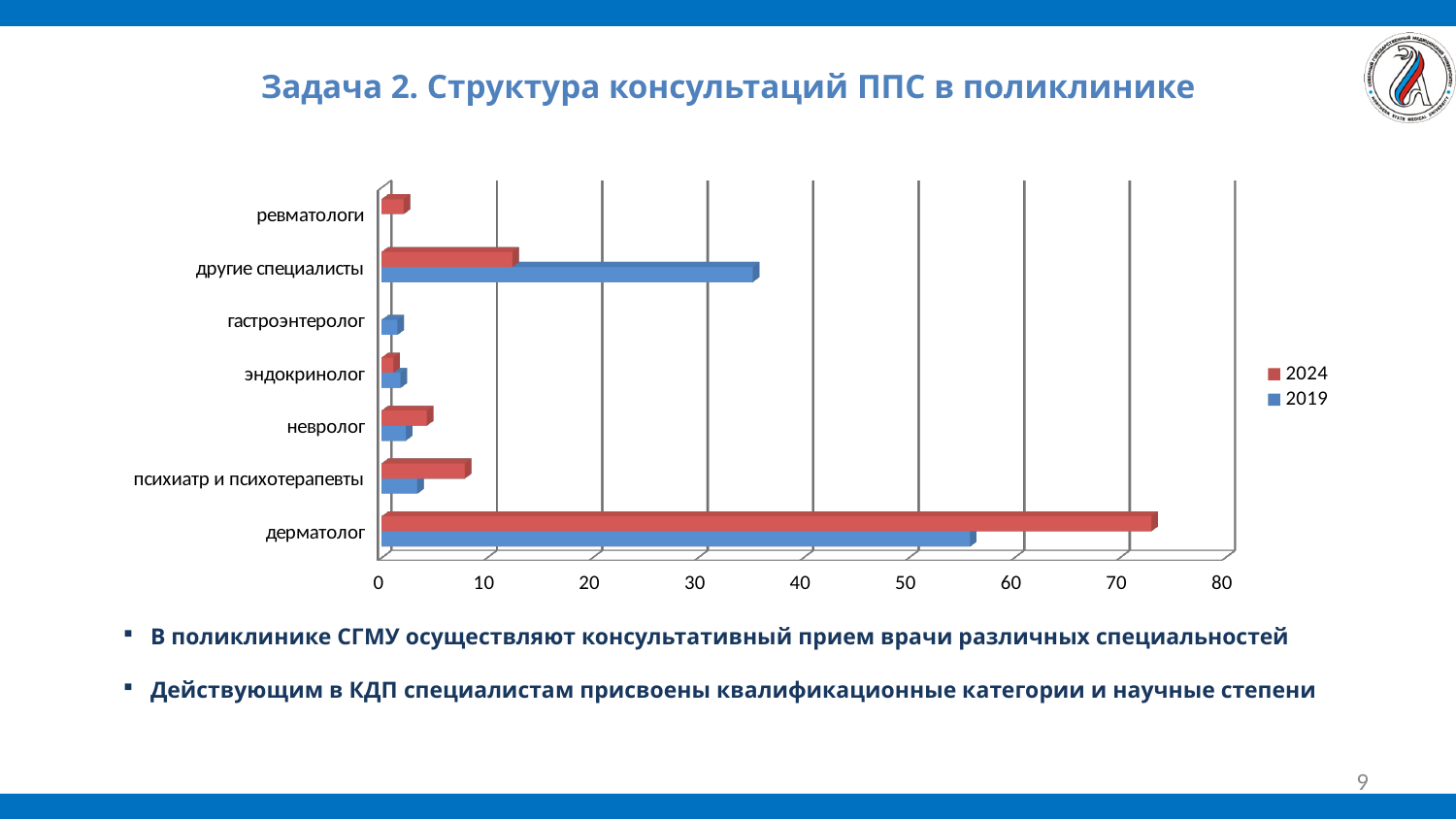
How many series does the legend list? 2 For дерматолог, which year has the larger value, 2024 or 2019? 2024 Which category has the highest value for 2019? дерматолог For другие специалисты, which year has the larger value, 2024 or 2019? 2019 Is the 2024 value for дерматолог greater or less than 70? greater Which colour represents the 2019 series in the chart? blue Is the 2024 value for другие специалисты greater or less than 20? less Which category has the highest value for 2024? дерматолог Is the 2019 value for дерматолог greater or less than 50? greater How many categories are shown on the vertical axis of the chart? 7 What kind of chart is shown on the slide? bar chart